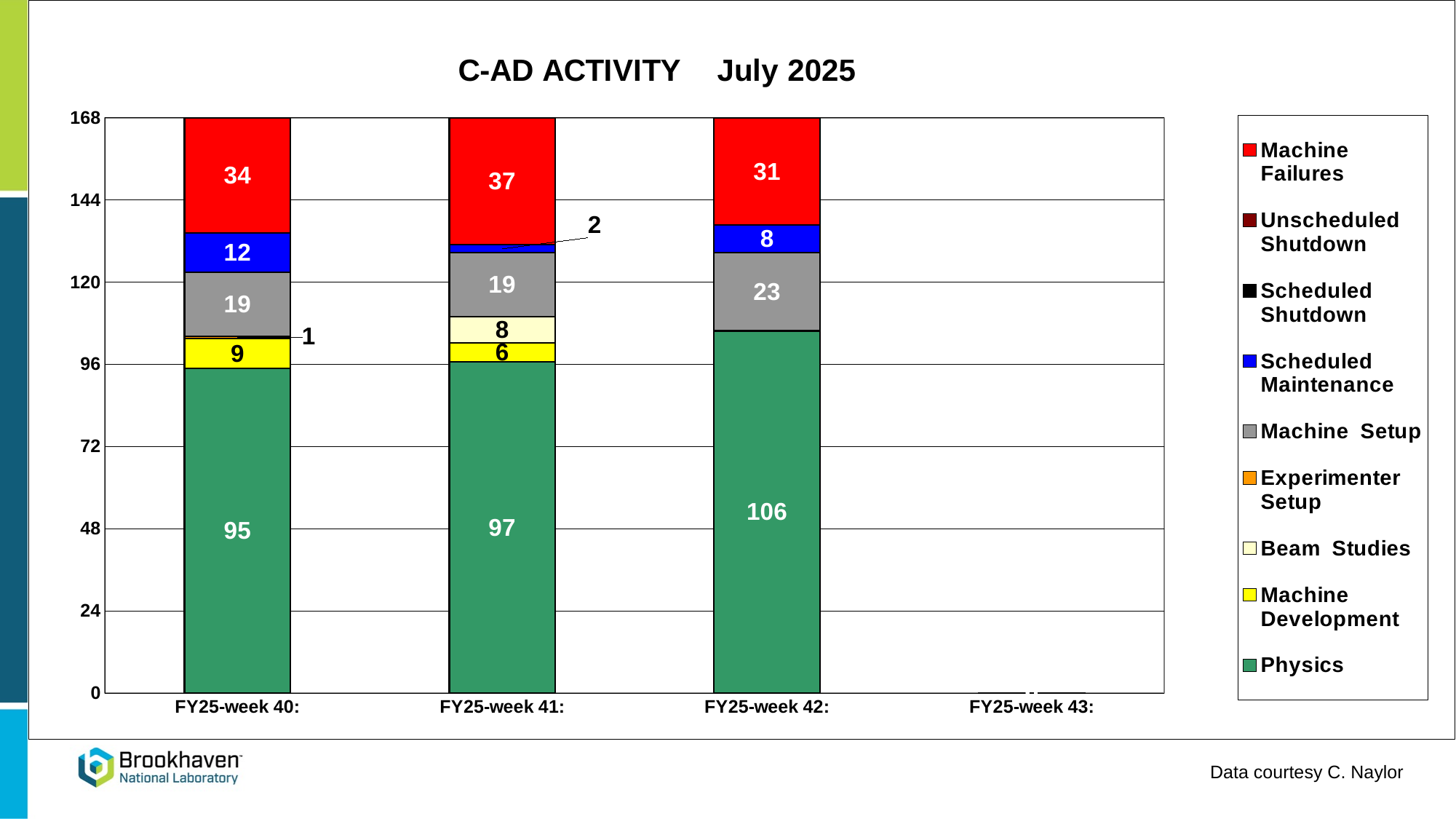
What is the total of the stacked bar for FY25-week 42? 168 Which week has the lowest Machine Failures value? FY25-week 42 What is the Scheduled Maintenance value for FY25-week 40? 12 Which has the larger Machine Setup value, FY25-week 40 or FY25-week 42? FY25-week 42 What is the difference between the Machine Failures values for FY25-week 41 and FY25-week 42? 6 Does the Physics value rise or fall from FY25-week 40 to FY25-week 42? Rise Which week has the highest Physics value? FY25-week 42 What is the Physics value for FY25-week 42? 106 What kind of chart is shown on the slide? Stacked bar chart How many series does the legend list? 9 What is the Beam Studies value for FY25-week 41? 8 What is the Machine Failures value for FY25-week 41? 37